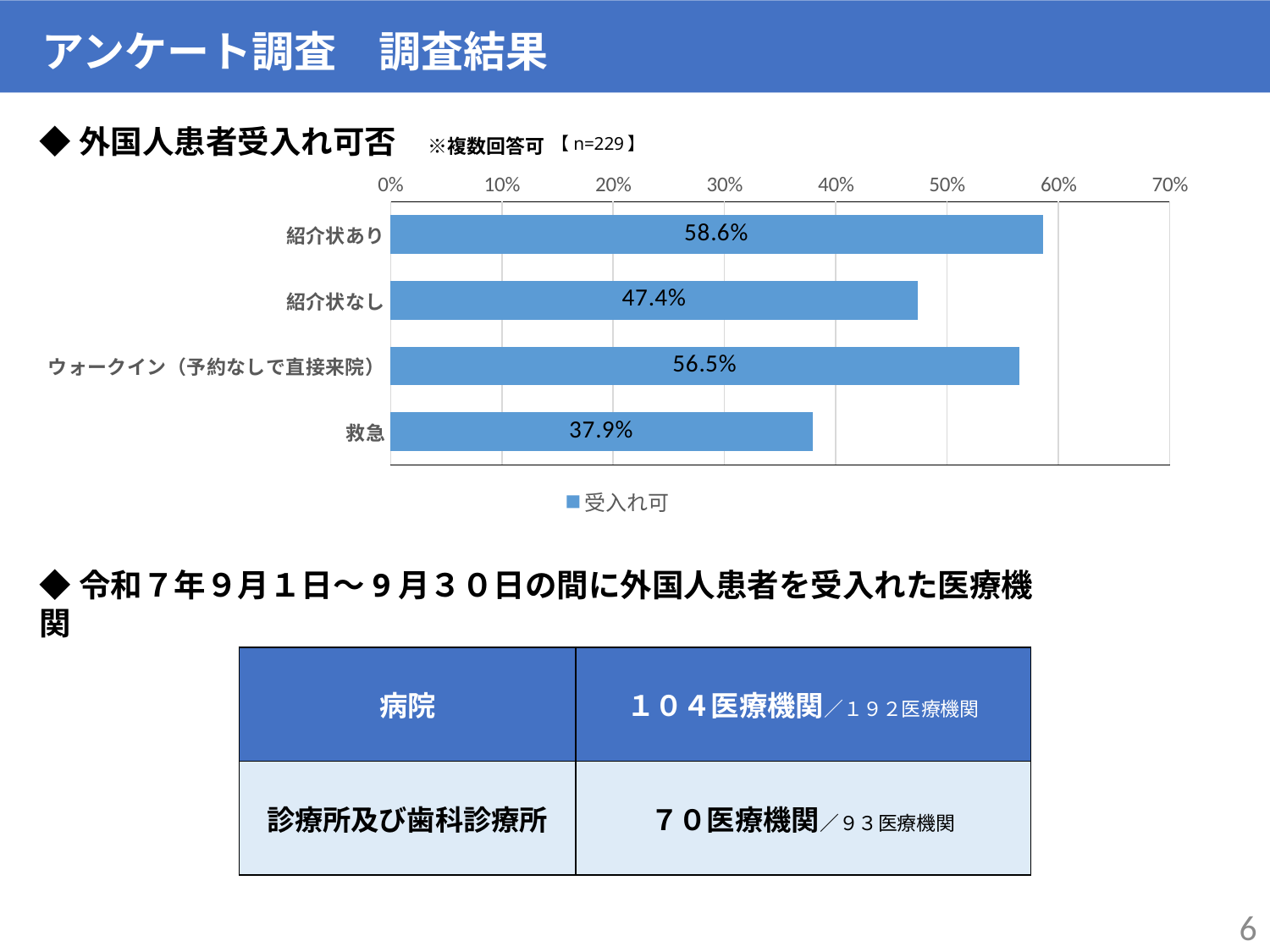
Which category has the lowest value? 救急 What is the difference between the values for 紹介状あり and 紹介状なし? 11.2% How many series does the legend list? 1 Is the value for 救急 greater or less than 40%? less What is the value for ウォークイン（予約なしで直接来院）? 56.5% How many categories are shown in the chart? 4 What kind of chart is shown? bar chart What is the value for 紹介状あり? 58.6% Which category has the highest value? 紹介状あり What is the value for 救急? 37.9% What is the legend entry of the chart? 受入れ可 Which is larger, the value for 紹介状なし or the value for ウォークイン（予約なしで直接来院）? ウォークイン（予約なしで直接来院）